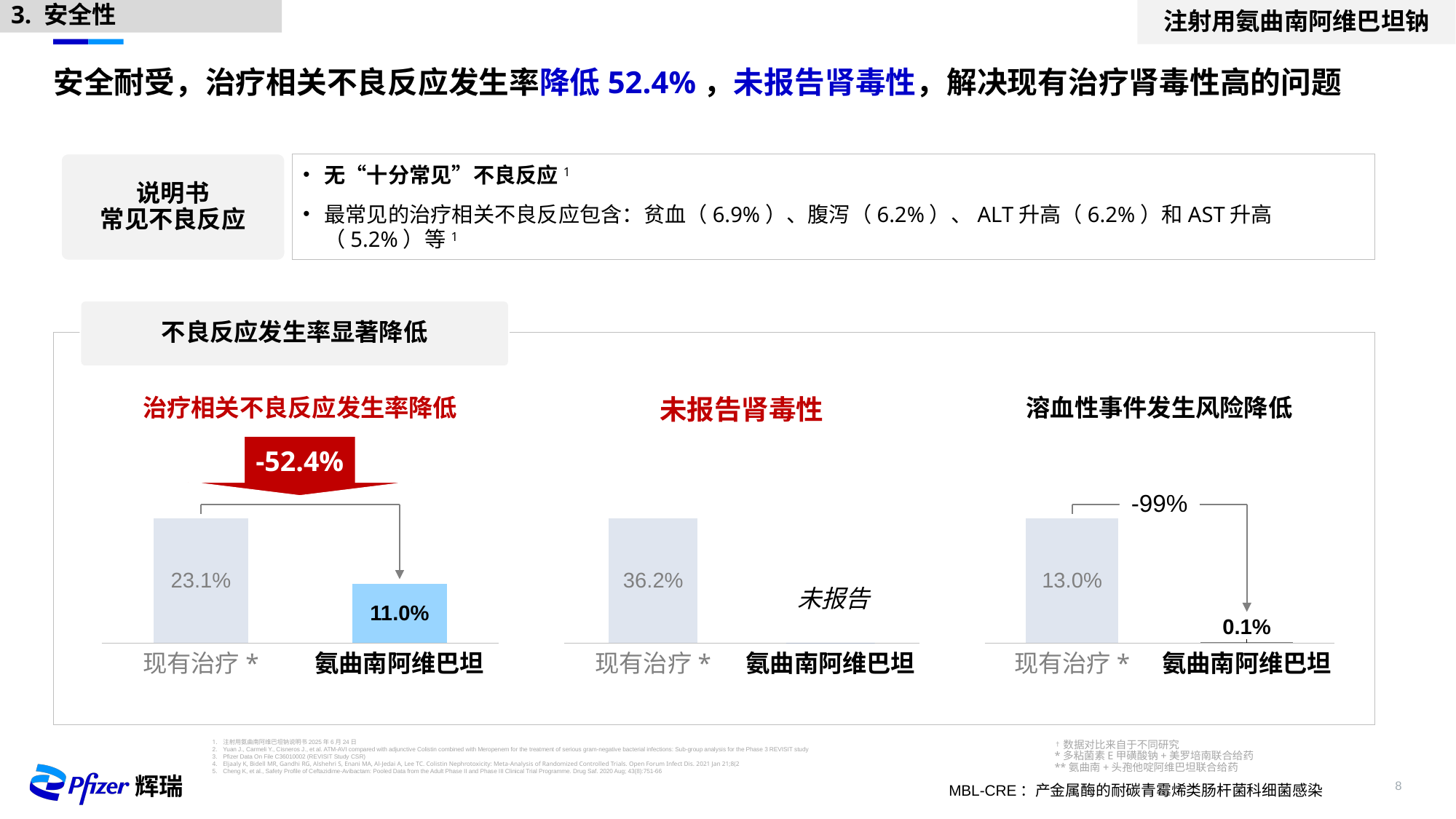
In the left chart titled 治疗相关不良反应发生率降低, what is the difference between the 现有治疗* value and the 氨曲南阿维巴坦 value? 12.1% In the right chart titled 溶血性事件发生风险降低, what is the value for 现有治疗*? 13.0% In the right chart titled 溶血性事件发生风险降低, which category has the lowest value? 氨曲南阿维巴坦 In the middle chart titled 未报告肾毒性, what is shown in place of a bar for 氨曲南阿维巴坦? 未报告 In the right chart titled 溶血性事件发生风险降低, what is the value for 氨曲南阿维巴坦? 0.1% In the left chart titled 治疗相关不良反应发生率降低, which category has the higher value, 现有治疗* or 氨曲南阿维巴坦? 现有治疗* In the right chart titled 溶血性事件发生风险降低, what percentage reduction is shown in the annotation above the bars? -99% In the left chart titled 治疗相关不良反应发生率降低, what is the value for 现有治疗*? 23.1% In the left chart titled 治疗相关不良反应发生率降低, what percentage reduction is shown in the red arrow annotation? -52.4% What kind of chart is the left chart titled 治疗相关不良反应发生率降低? bar chart In the left chart titled 治疗相关不良反应发生率降低, what is the value for 氨曲南阿维巴坦? 11.0% In the middle chart titled 未报告肾毒性, what is the value for 现有治疗*? 36.2%